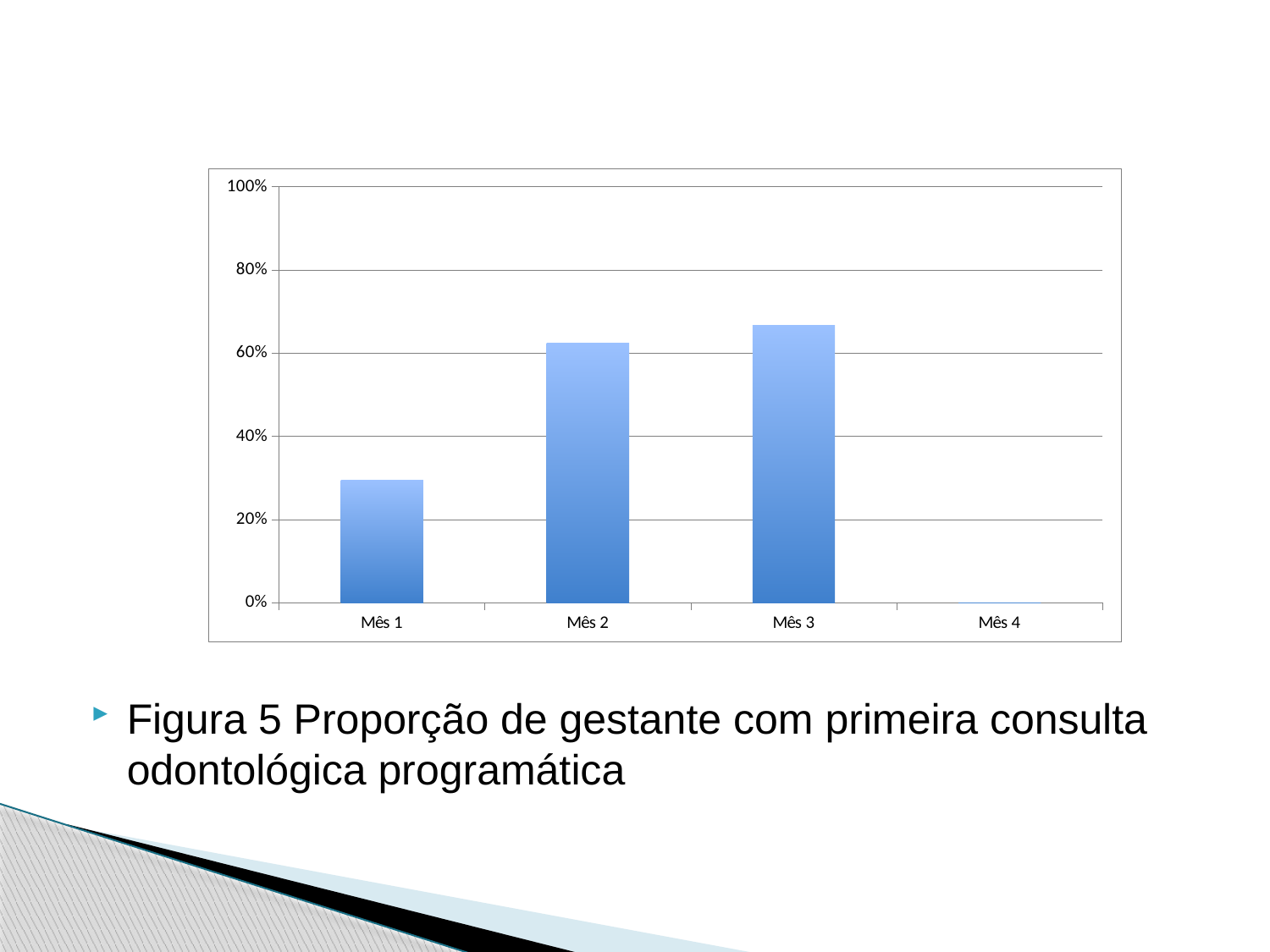
What kind of chart is shown on the slide? bar chart Which month has the lowest value in the chart? Mês 4 Is the value for Mês 2 greater or less than 40%? greater Which is larger, the value for Mês 1 or the value for Mês 2? Mês 2 Is the value for Mês 1 greater or less than 40%? less Is the value for Mês 3 greater or less than 80%? less Do the values rise or fall from Mês 1 to Mês 3? rise How many categories (months) are shown on the x axis of the chart? 4 Which month has the highest value in the chart? Mês 3 What is the highest value shown on the chart's vertical axis? 100%